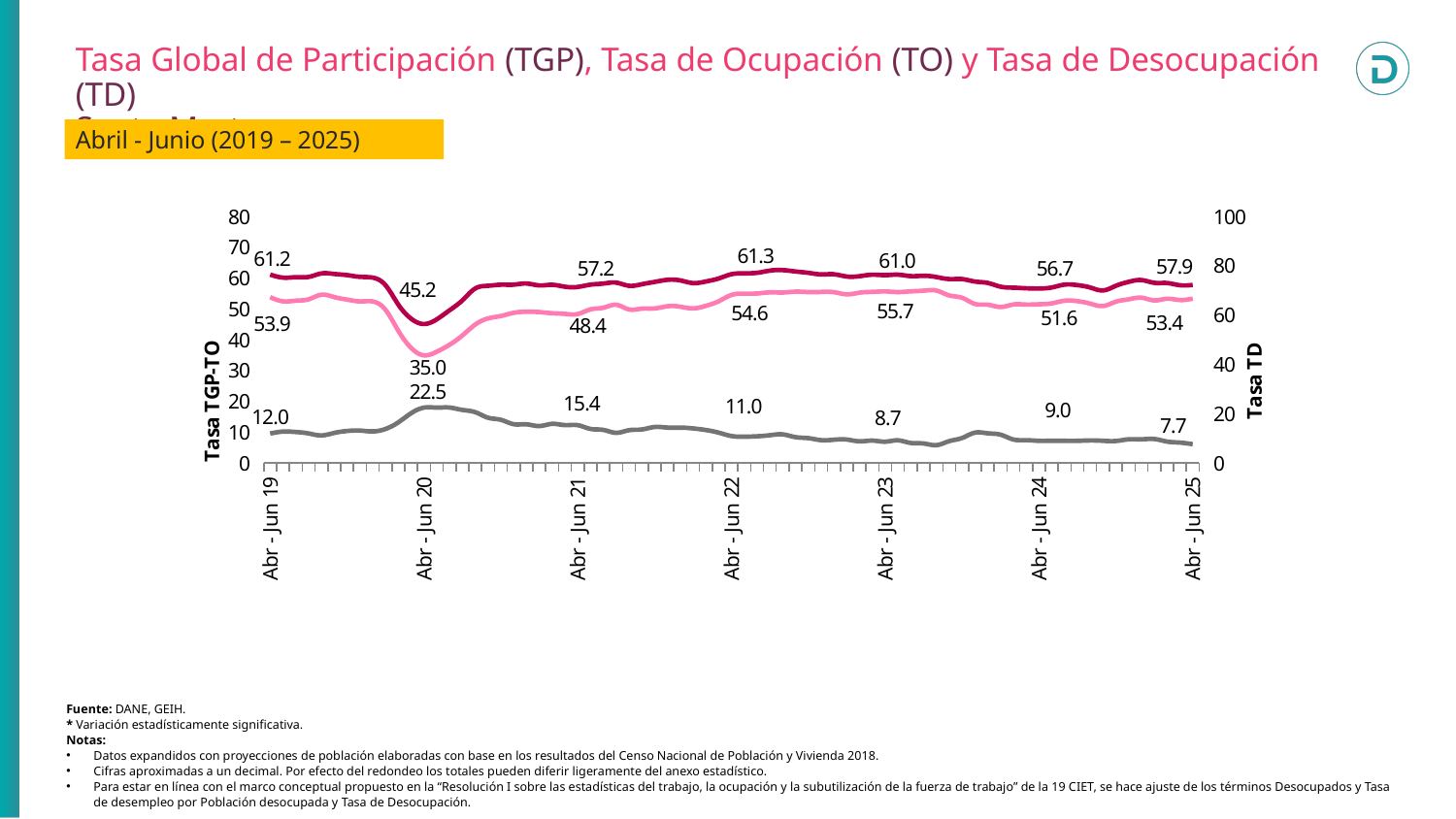
Does the bottom line (TD) rise or fall from Abr - Jun 20 to Abr - Jun 23? Fall What is the labeled value of the top line (TGP) at Abr - Jun 25? 57.9 What is the title of the right-hand vertical axis? Tasa TD For the middle line (TO), which labeled value is larger: Abr - Jun 22 or Abr - Jun 23? Abr - Jun 23 At which labeled period does the top line (TGP) reach its lowest labeled value? Abr - Jun 20 What type of chart is shown on the slide? Line chart By how much does the top line (TGP) fall from Abr - Jun 19 to Abr - Jun 20, using the labeled values? 16.0 What is the labeled value of the bottom line (TD) at Abr - Jun 20? 22.5 At which labeled period does the bottom line (TD) reach its highest labeled value? Abr - Jun 20 What is the difference between the bottom line (TD) labeled values at Abr - Jun 20 and Abr - Jun 25? 14.8 What is the labeled value of the middle line (TO) at Abr - Jun 23? 55.7 How many labeled periods are shown on the x axis? 7